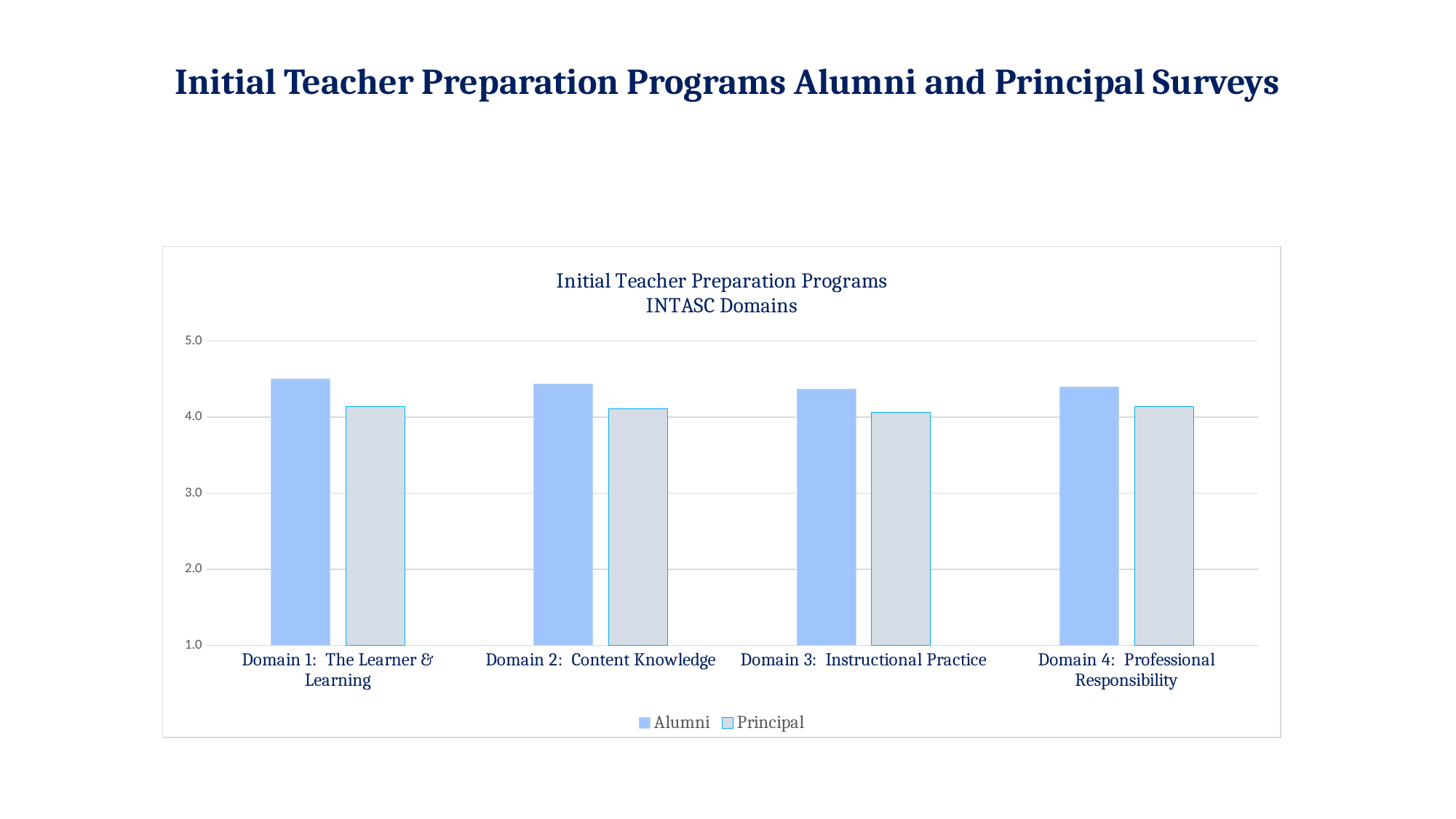
What kind of chart is shown on the slide? bar chart For Domain 1: The Learner & Learning, which series has the larger value, Alumni or Principal? Alumni How many domains (categories) are shown on the x axis of the chart? 4 How many series does the chart's legend list? 2 For Domain 4: Professional Responsibility, which series has the larger value, Alumni or Principal? Alumni What are the two series named in the chart's legend? Alumni and Principal For Domain 3: Instructional Practice, is the Principal value larger or smaller than the Alumni value? smaller Which domain has the highest Alumni value? Domain 1: The Learner & Learning Is the Alumni value for Domain 1: The Learner & Learning greater or less than 4.0? greater Is the Alumni value for Domain 2: Content Knowledge greater or less than 5.0? less What is the title of the chart? Initial Teacher Preparation Programs INTASC Domains